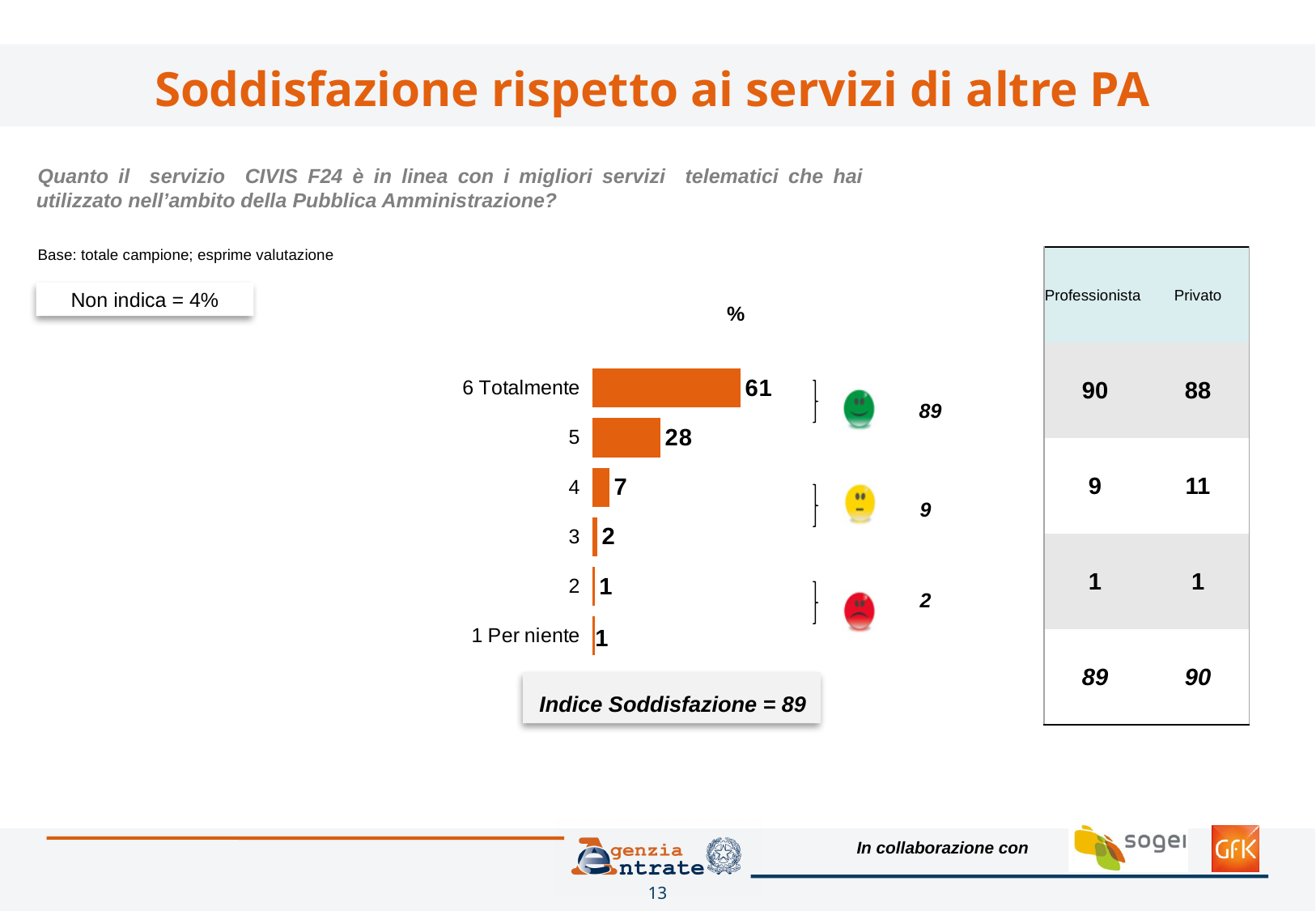
What is the value for the category "5"? 28 What is the value for the category "6 Totalmente"? 61 What is the difference between the values for "5" and "4"? 21 What is the value for the category "1 Per niente"? 1 What is the difference between the values for "6 Totalmente" and "5"? 33 What kind of chart is shown on the slide? Bar chart What is the Indice Soddisfazione shown below the chart? 89 How many categories are shown in the bar chart? 6 Do the values decrease or increase going from "6 Totalmente" down to "1 Per niente"? Decrease What is the value for the category "4"? 7 Which category has the highest value? 6 Totalmente Which is larger, the value for "4" or the value for "3"? 4